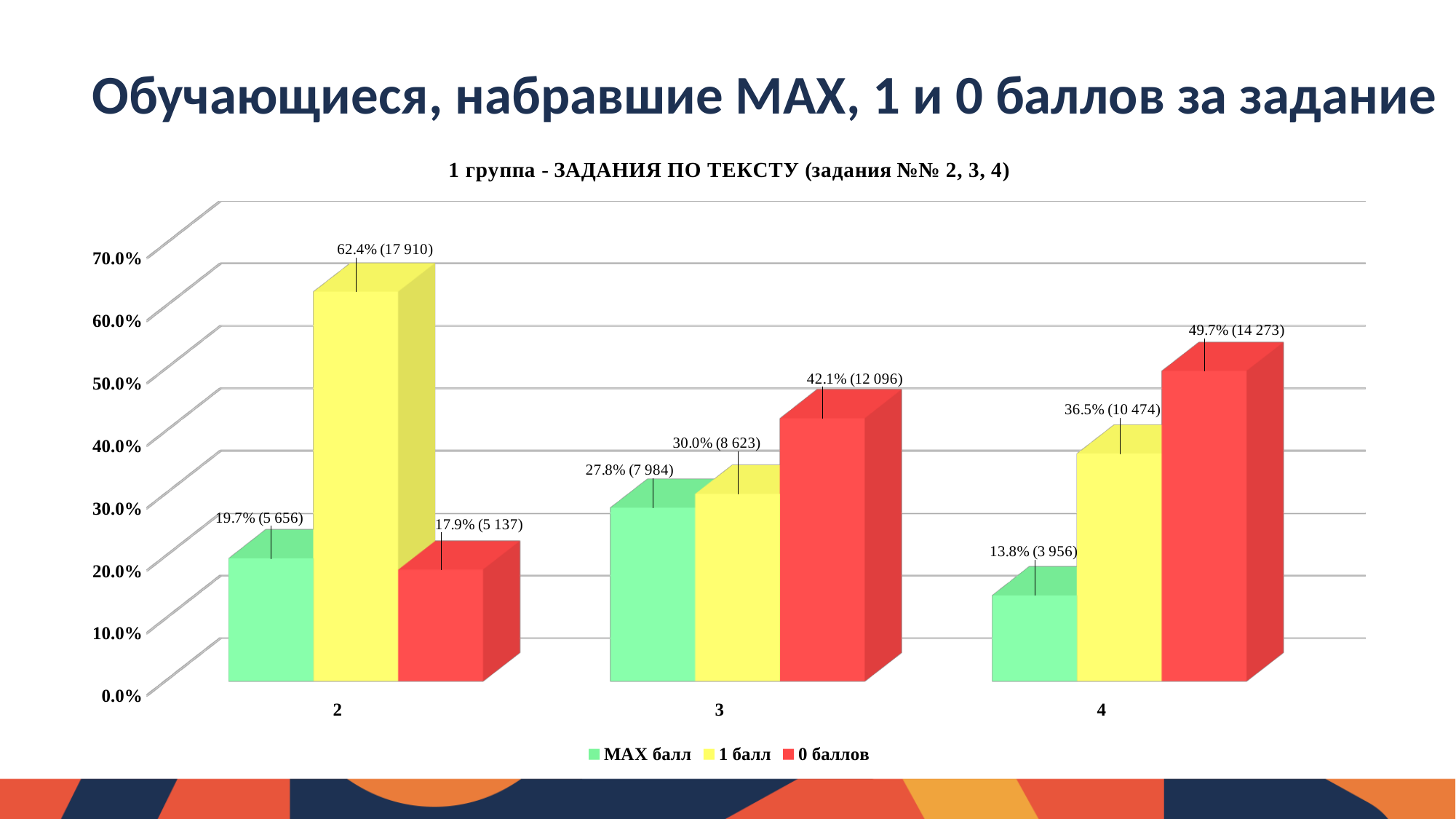
What is the value for "1 балл" for task 2? 62.4% (17 910) Is the value for "1 балл" for task 2 greater or less than 60.0%? greater How many series does the legend list? 3 For task 3, which is larger: "0 баллов" or "1 балл"? 0 баллов What kind of chart is shown on the slide? bar chart Which colour represents the "0 баллов" series? red What is the difference in percentage points between "1 балл" and "MAX балл" for task 4? 22.7 What is the value for "0 баллов" for task 4? 49.7% (14 273) What is the value for "MAX балл" for task 3? 27.8% (7 984) Which task has the highest value for "MAX балл"? 3 How many task categories are shown on the x axis? 3 Which task has the lowest value for "0 баллов"? 2